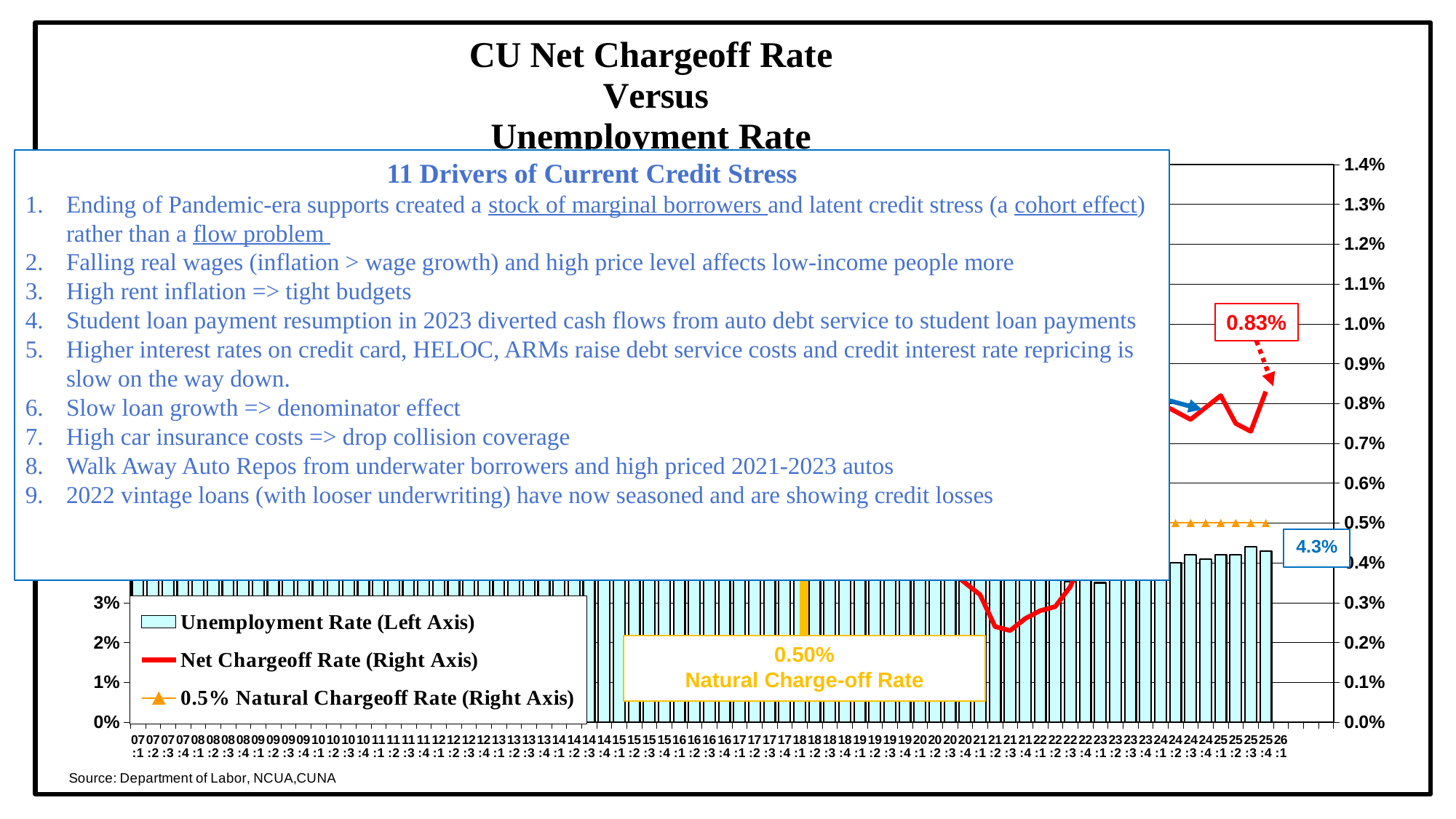
What is the difference between the labelled Net Chargeoff Rate (0.83%) and the Natural Charge-off Rate (0.50%)? 0.33% What is the labelled value of the Unemployment Rate at the right end of the bars? 4.3% Which is larger, the labelled Net Chargeoff Rate of 0.83% or the Natural Charge-off Rate of 0.50%? Net Chargeoff Rate (0.83%) What is the labelled value of the Net Chargeoff Rate at the right end of the red line? 0.83% Is the lowest point of the Net Chargeoff Rate line in 2021 greater or less than 0.3%? less Is the Unemployment Rate in 2025 greater or less than 3%? greater How many series does the chart legend list? 3 What is the title of the chart? CU Net Chargeoff Rate Versus Unemployment Rate What value is given for the Natural Charge-off Rate? 0.50% On which axis is the Net Chargeoff Rate plotted? Right Axis Do the Unemployment Rate bars rise or fall from 2023 to 2025? rise What kind of chart is used to show the Unemployment Rate series? Bar chart